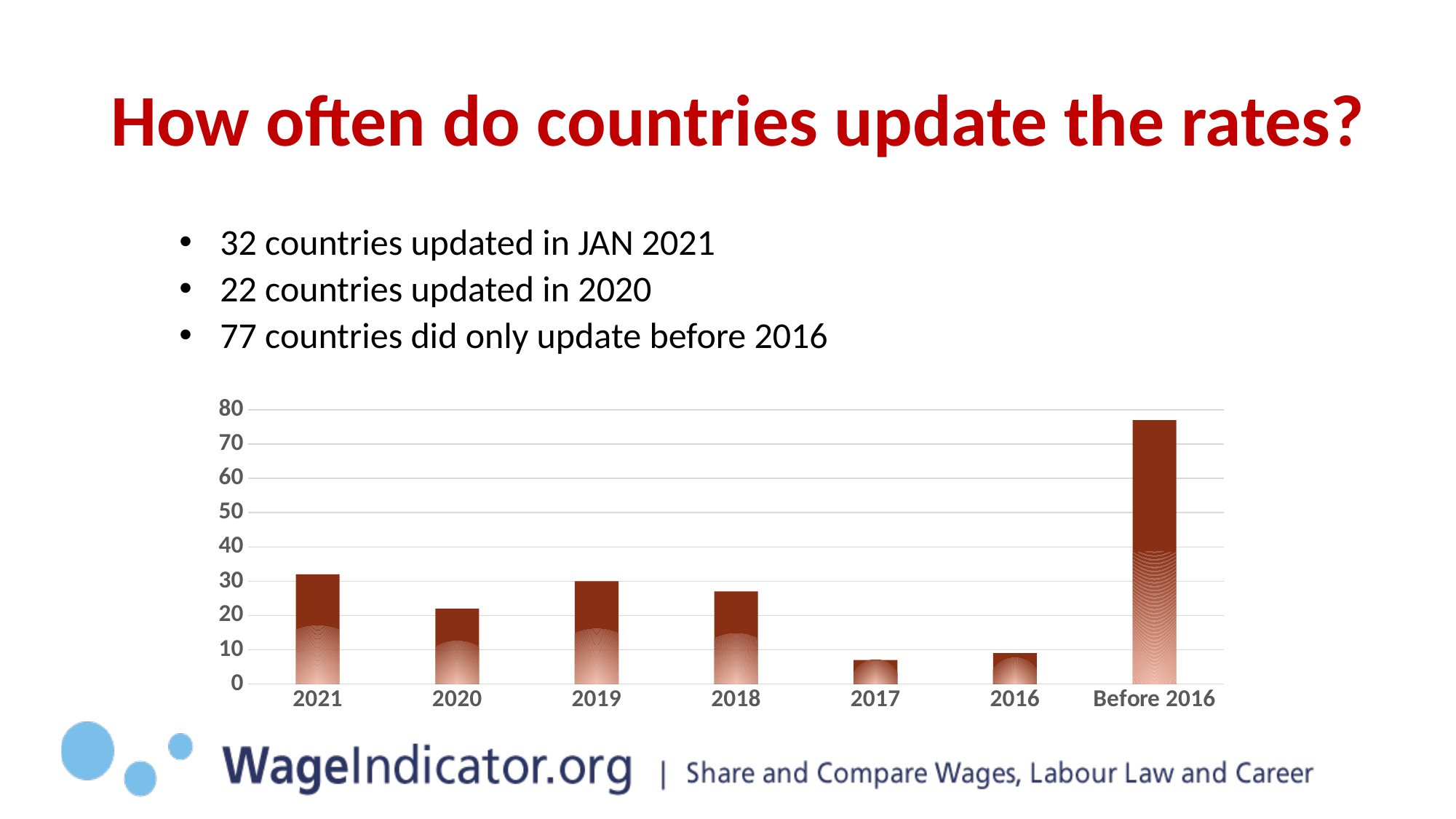
Is the value for 2017 greater or less than 10? less How many countries updated in 2020 according to the slide? 22 Is the value for 2018 greater or less than 20? greater How many categories are shown on the x axis of the chart? 7 Which bar is taller, 2019 or 2018? 2019 How many countries updated in 2021 according to the slide? 32 What is the difference between the number of countries in the Before 2016 category and the 2021 category? 45 Which category has the highest bar in the chart? Before 2016 What kind of chart is shown on the slide? bar chart How many countries did only update before 2016 according to the slide? 77 Which category has the lowest bar in the chart? 2017 What is the difference between the number of countries that updated in 2021 and in 2020? 10